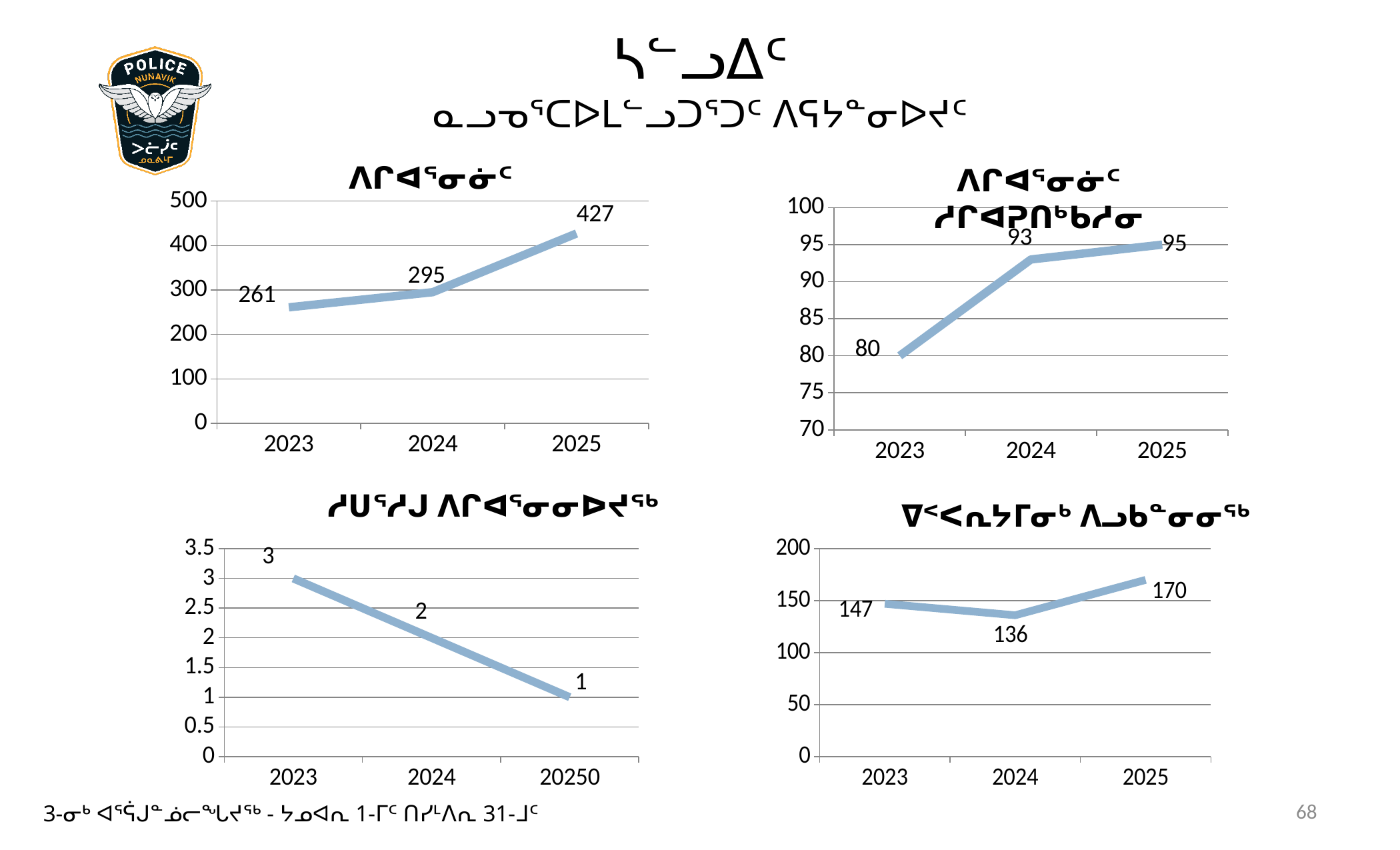
In the top-right chart, which year has the lowest value? 2023 What kind of chart is the top-left chart? line chart In the bottom-right chart, is the value for 2023 larger or smaller than the value for 2024? larger In the bottom-right chart, what is the value for 2024? 136 In the top-left chart, what is the difference between the 2025 and 2024 values? 132 In the bottom-left chart, do the values rise or fall from 2023 to 2025? fall In the bottom-right chart, which year has the highest value? 2025 In the top-right chart, do the values rise or fall from 2023 to 2025? rise In the bottom-left chart, what is the value for 2024? 2 In the top-right chart, what is the value for 2024? 93 In the top-left chart, what is the value for 2025? 427 In the top-left chart, what is the value for 2023? 261